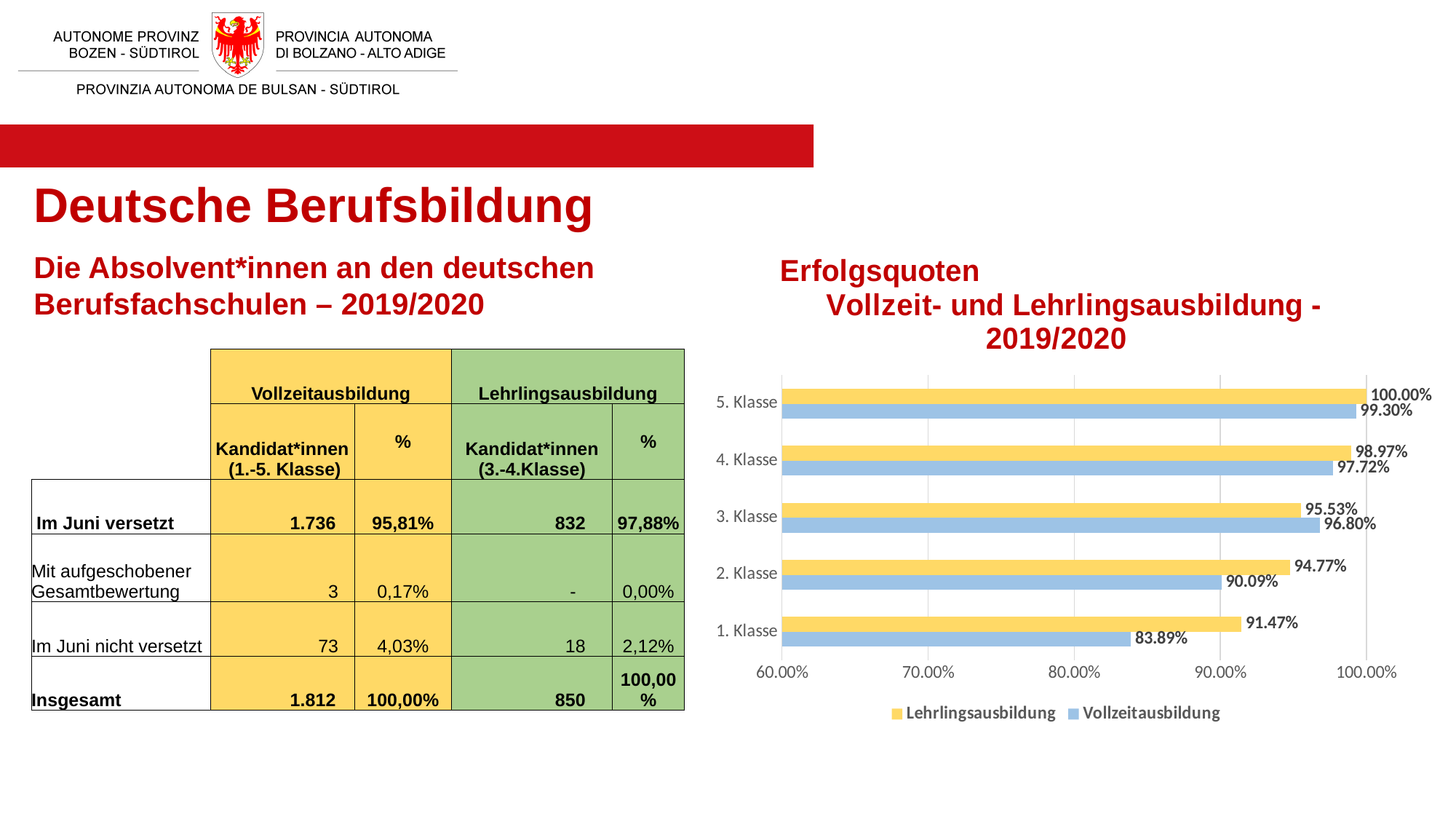
What type of chart is shown under the title 'Erfolgsquoten Vollzeit- und Lehrlingsausbildung - 2019/2020'? Bar chart In the Erfolgsquoten chart, what is the value for Lehrlingsausbildung in 5. Klasse? 100.00% How many classes are shown in the Erfolgsquoten chart? 5 In the Erfolgsquoten chart, which class has the highest Lehrlingsausbildung value? 5. Klasse In the Erfolgsquoten chart, what is the difference between the Lehrlingsausbildung and Vollzeitausbildung values for 2. Klasse? 4.68 percentage points In the Erfolgsquoten chart, what is the value for Vollzeitausbildung in 3. Klasse? 96.80% In the Erfolgsquoten chart, what is the difference between the Lehrlingsausbildung and Vollzeitausbildung values for 1. Klasse? 7.58 percentage points In the Erfolgsquoten chart, is the Vollzeitausbildung value for 2. Klasse greater or less than 90.00%? greater In the Erfolgsquoten chart, what is the value for Vollzeitausbildung in 1. Klasse? 83.89% In the Erfolgsquoten chart, which is larger for 3. Klasse: Lehrlingsausbildung or Vollzeitausbildung? Vollzeitausbildung How many series does the legend of the Erfolgsquoten chart list? 2 In the Erfolgsquoten chart, which class has the lowest Vollzeitausbildung value? 1. Klasse